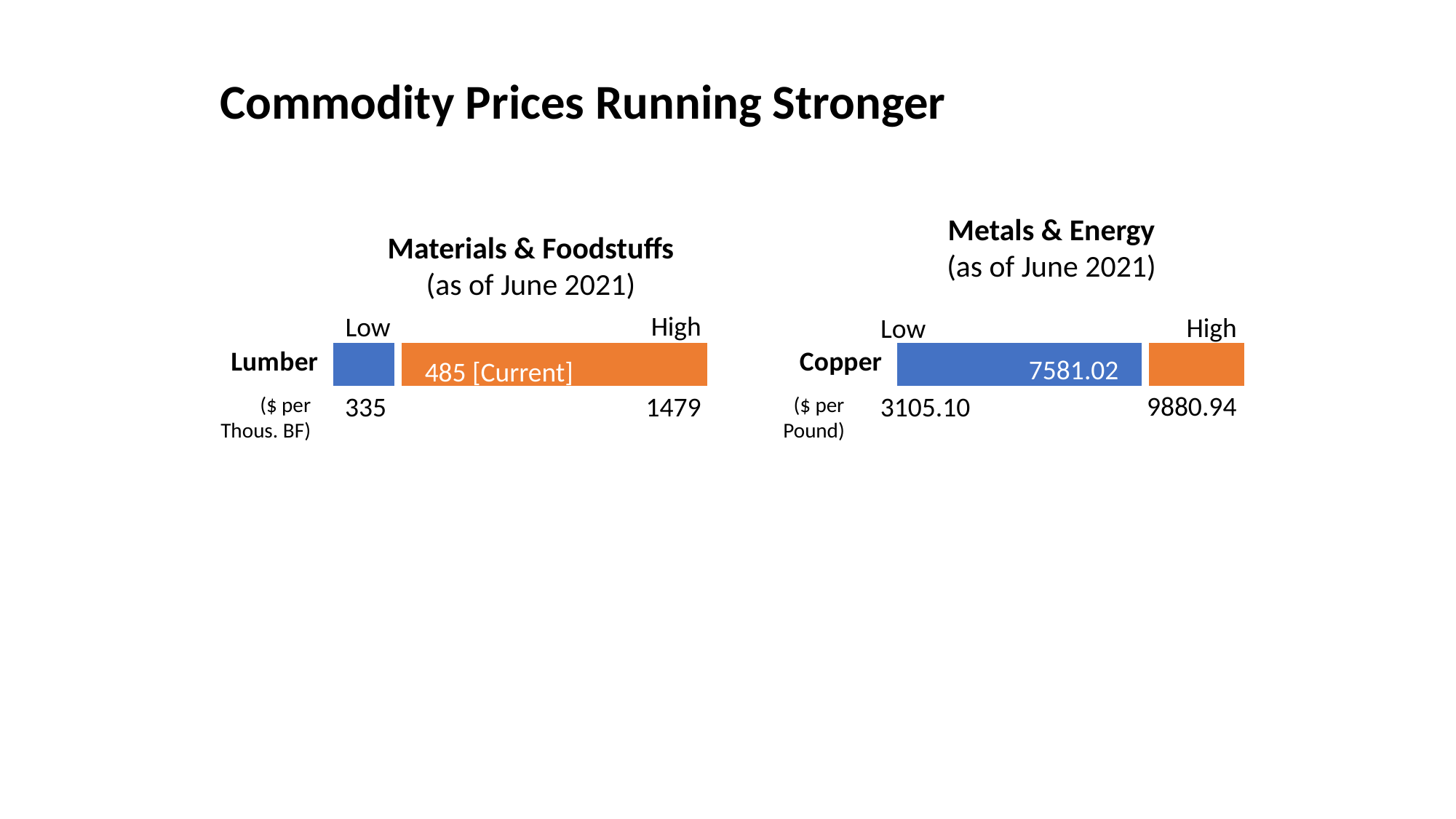
What kind of chart is the Metals & Energy chart? Bar chart In the Materials & Foodstuffs chart, what is the current price of Lumber? 485 In the Metals & Energy chart, what is the Low value for Copper? 3105.10 In the Metals & Energy chart, what is the current price of Copper? 7581.02 In the Metals & Energy chart, what unit is the Copper price given in? $ per Pound In the Materials & Foodstuffs chart, what is the High value for Lumber? 1479 In the Materials & Foodstuffs chart, is the current Lumber price closer to the Low or the High value? Low In the Materials & Foodstuffs chart, what is the Low value for Lumber? 335 In the Metals & Energy chart, what is the difference between the High and Low values for Copper? 6775.84 In the Materials & Foodstuffs chart, what is the difference between the High and Low values for Lumber? 1144 In the Metals & Energy chart, what is the High value for Copper? 9880.94 In the Materials & Foodstuffs chart, what unit is the Lumber price given in? $ per Thous. BF